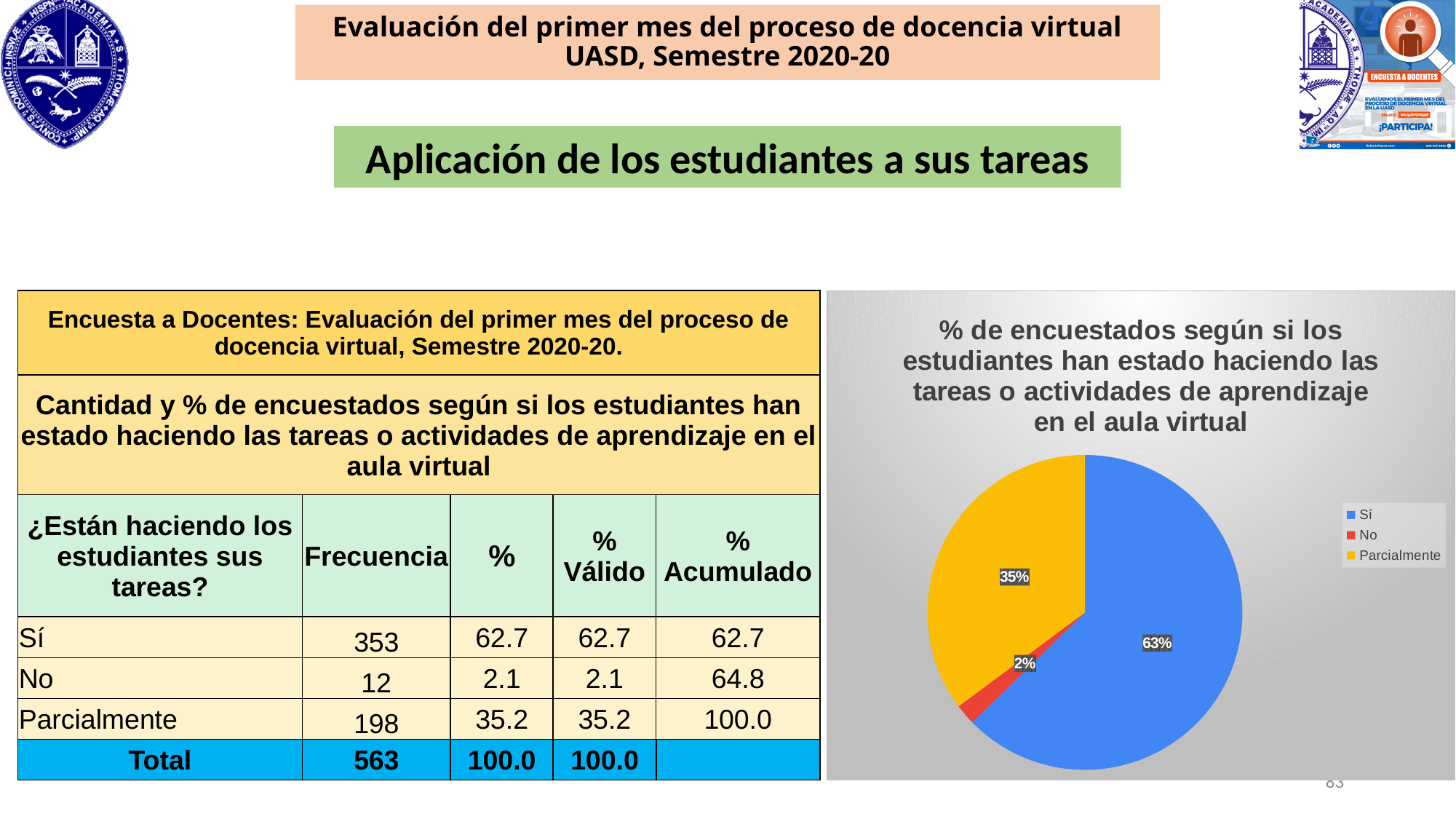
What is the difference in percentage points between the Sí slice and the Parcialmente slice in the pie chart? 28% How many entries does the legend of the pie chart list? 3 What is the value shown for the No slice of the pie chart? 2% What is the title of the pie chart? % de encuestados según si los estudiantes han estado haciendo las tareas o actividades de aprendizaje en el aula virtual What is the value shown for the Parcialmente slice of the pie chart? 35% Which category has the smallest slice in the pie chart? No What is the value shown for the Sí slice of the pie chart? 63% Which is larger in the pie chart, the Sí slice or the Parcialmente slice? Sí What kind of chart is shown on the slide? pie chart How many categories does the pie chart show? 3 Which category has the largest slice in the pie chart? Sí What colour is the Parcialmente slice in the pie chart? yellow